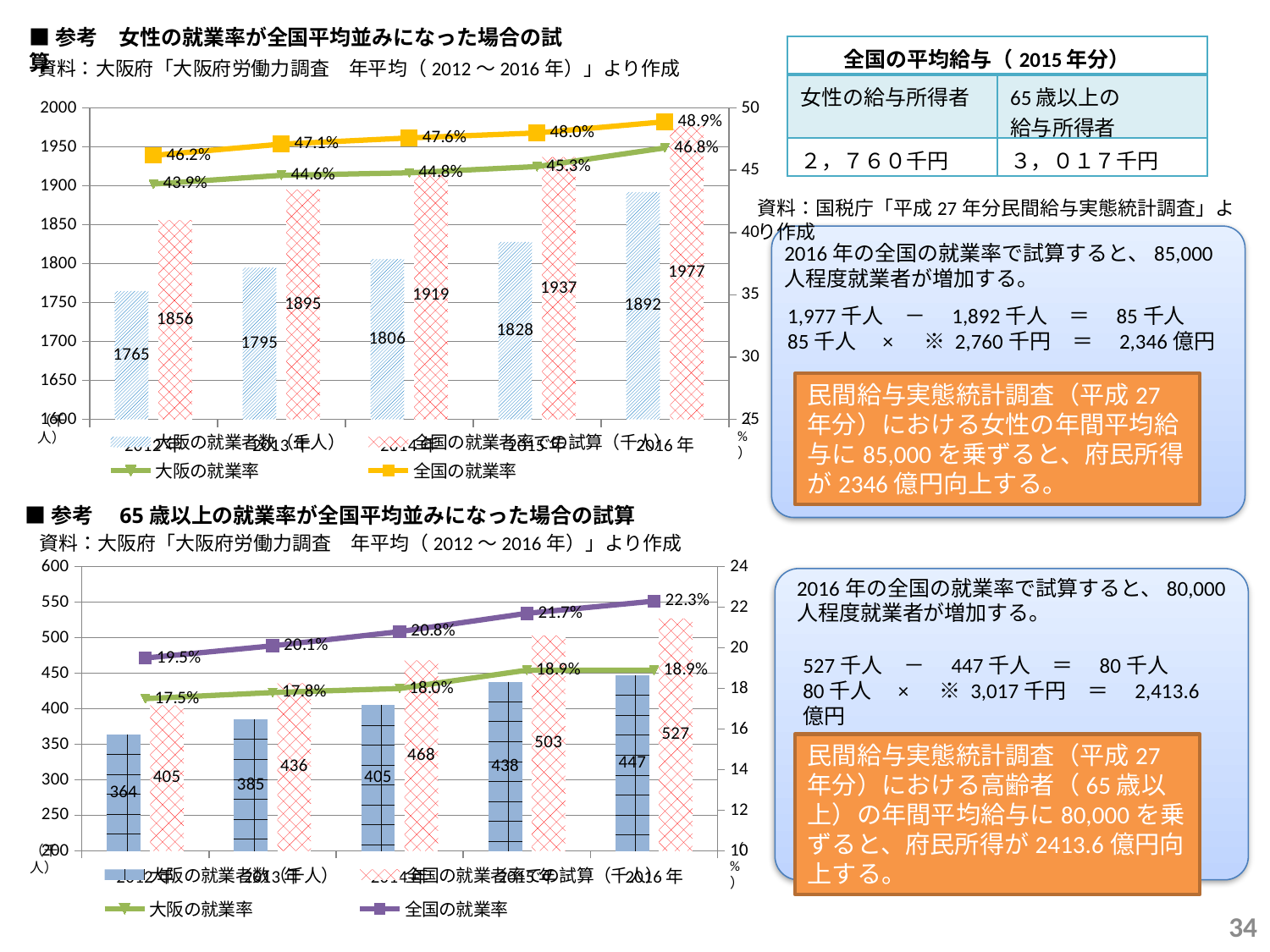
上のグラフ（女性の就業率）で、2014年の「全国の就業率」の値はいくつですか？ 47.6% 下のグラフ（65歳以上の就業率）で、2014年の「大阪の就業者数（千人）」と「全国の就業者率での試算（千人）」ではどちらが大きいですか？ 全国の就業者率での試算（千人） 下のグラフ（65歳以上の就業率）で、「大阪の就業者数（千人）」が最も低いのは何年ですか？ 2012年 下のグラフ（65歳以上の就業率）で、2016年の「全国の就業者率での試算（千人）」と「大阪の就業者数（千人）」の差はいくつですか？ 80 上のグラフ（女性の就業率）の凡例には、いくつの系列が示されていますか？ 4 上のグラフ（女性の就業率）で、2016年の「全国の就業者率での試算（千人）」と「大阪の就業者数（千人）」の差はいくつですか？ 85 上のグラフ（女性の就業率）で、2016年の「大阪の就業者数（千人）」の値はいくつですか？ 1892 上のグラフ（女性の就業率）で、「大阪の就業率」は2012年から2016年にかけて上昇していますか、下降していますか？ 上昇 下のグラフ（65歳以上の就業率）で、2012年の「全国の就業率」の値はいくつですか？ 19.5% 下のグラフ（65歳以上の就業率）で、2015年の「全国の就業者率での試算（千人）」の値はいくつですか？ 503 下のグラフ（65歳以上の就業率）には、横軸にいくつの年（カテゴリ）が示されていますか？ 5 上のグラフ（女性の就業率）で、「全国の就業者率での試算（千人）」が最も高いのは何年ですか？ 2016年